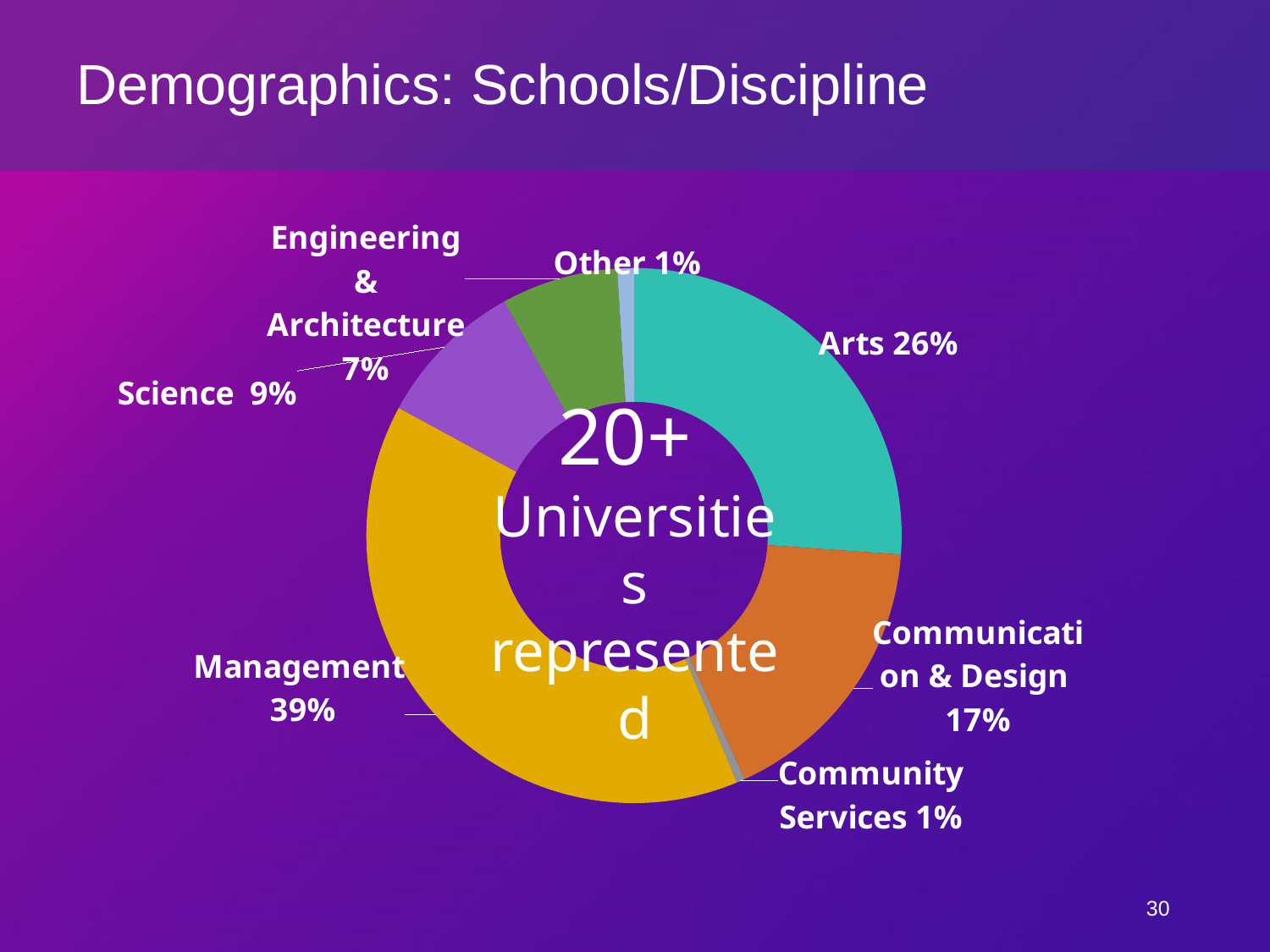
What share of the pie does Arts hold? 26% What kind of chart is shown on the slide? Pie chart (doughnut) What share of the pie does Management hold? 39% How many categories are shown in the pie chart? 7 What is the value for Science? 9% What text is shown in the centre of the doughnut chart? 20+ Universities represented What is the difference between the Management and Arts shares? 13% What is the value for Communication & Design? 17% What is the value for Engineering & Architecture? 7% Which category is larger, Arts or Communication & Design? Arts Which category has the largest share of the pie? Management What is the value for Community Services? 1%